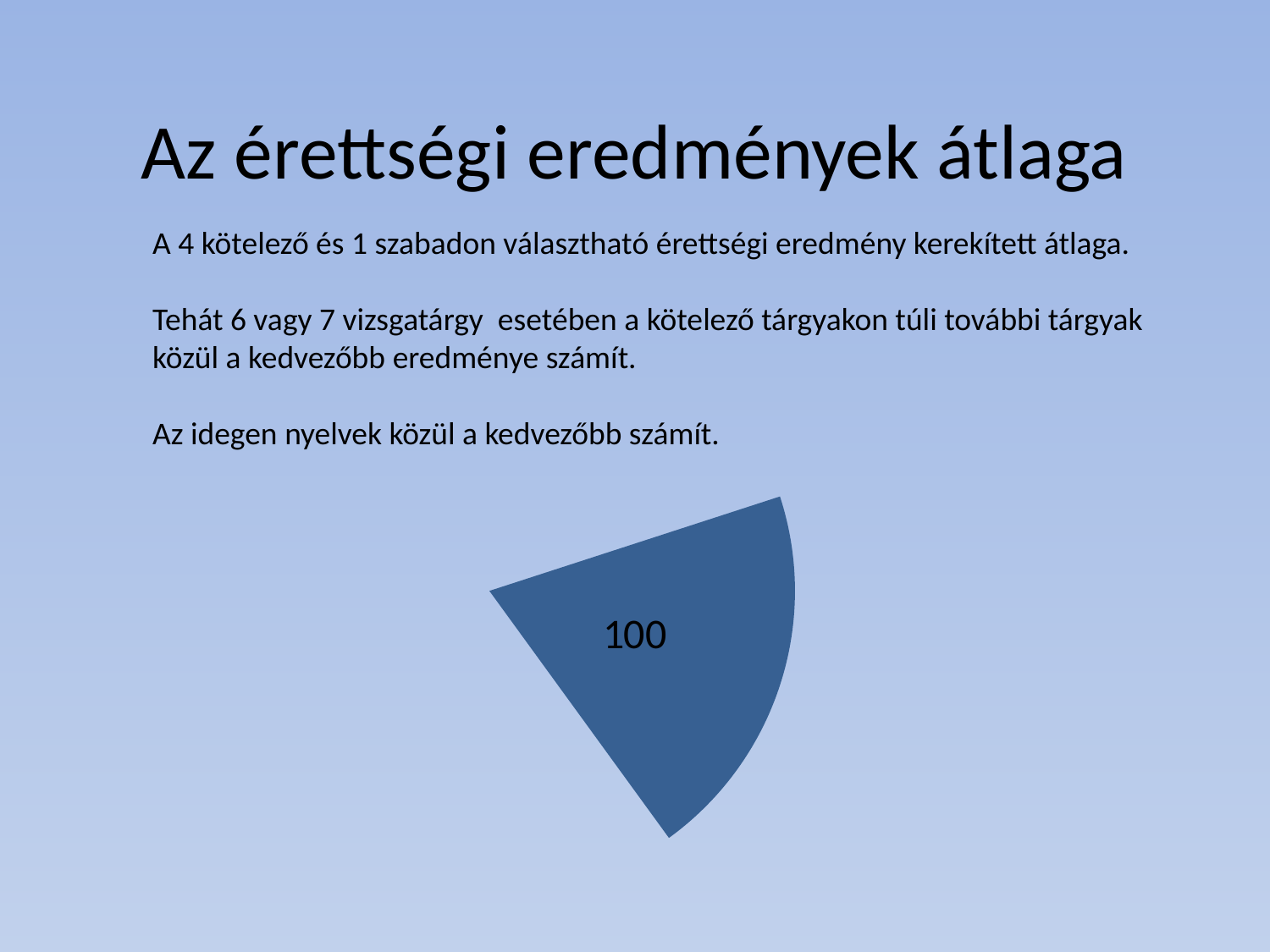
How many data labels are printed on the pie chart? 1 What value is printed on the visible slice of the pie chart? 100 Does the pie chart display a legend? No What colour is the visible slice of the pie chart? blue What kind of chart is shown on the slide? pie chart How many slices are visibly drawn on the pie chart? 1